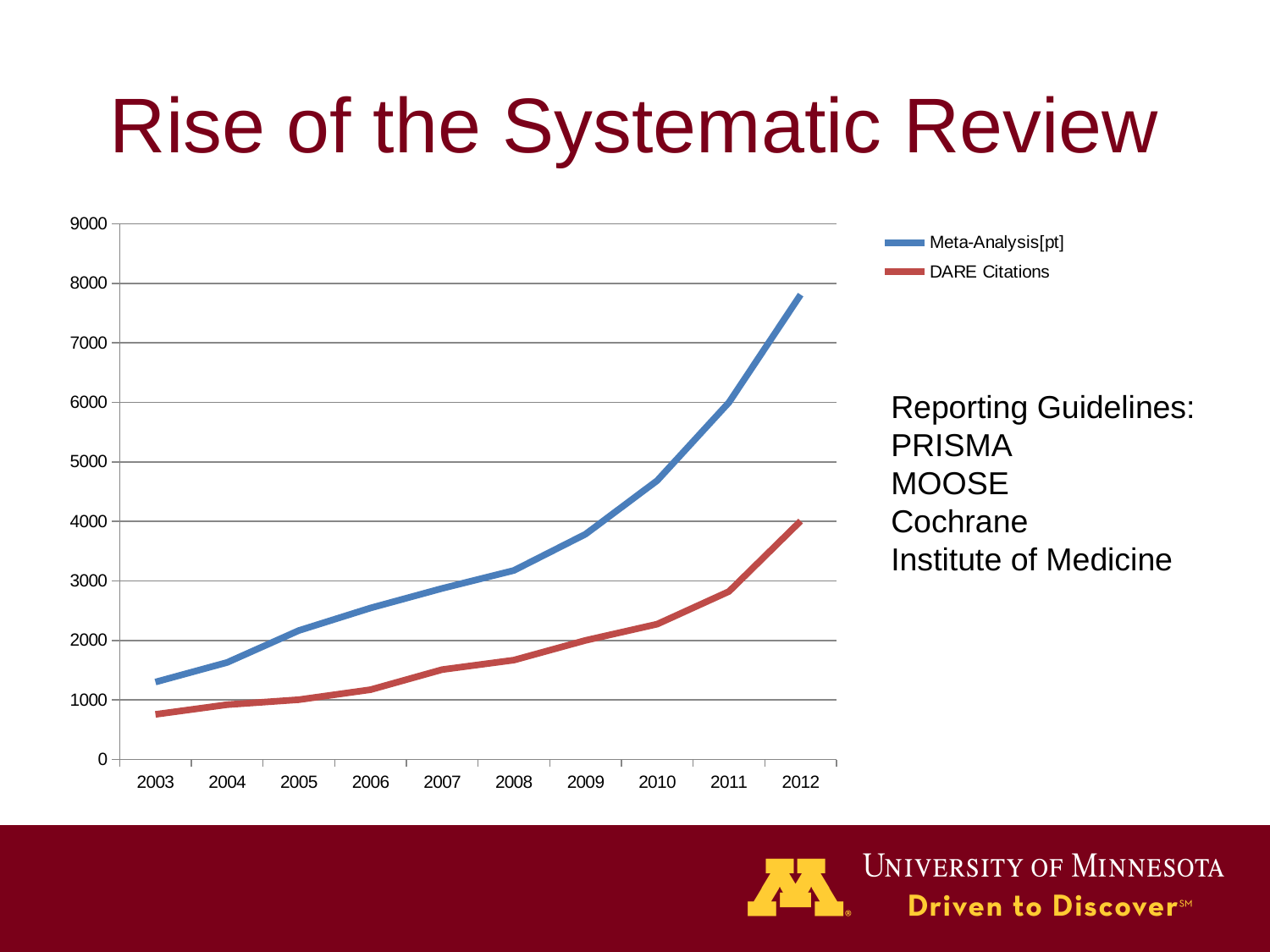
How many years are shown on the x axis? 10 What kind of chart is shown on the slide? line chart What are the two series named in the legend? Meta-Analysis[pt] and DARE Citations Which series has the larger value in 2012, Meta-Analysis[pt] or DARE Citations? Meta-Analysis[pt] Which year has the highest value for Meta-Analysis[pt]? 2012 Do the Meta-Analysis[pt] values rise or fall from 2003 to 2012? rise How many series does the legend list? 2 Which year has the lowest value for DARE Citations? 2003 Is the value for DARE Citations in 2011 greater or less than 3000? less Is the value for Meta-Analysis[pt] in 2012 greater or less than 7000? greater Is the value for Meta-Analysis[pt] in 2010 greater or less than 4000? greater